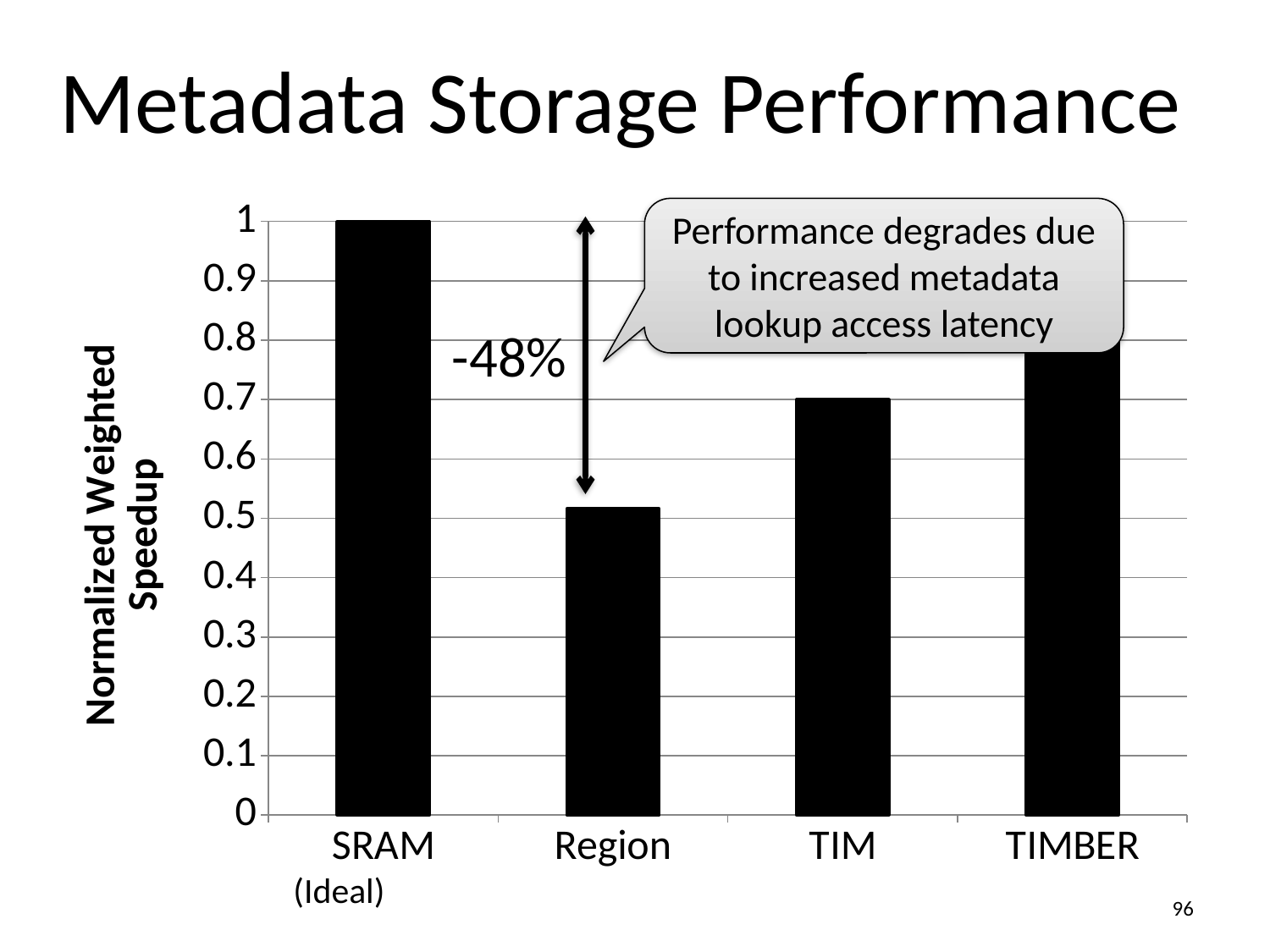
Which category has the highest normalized weighted speedup? SRAM (Ideal) Is the value for TIM greater or less than 0.8? less What percentage change is annotated between the SRAM and Region bars? -48% How many categories are plotted on the x axis? 4 Which category has the lowest normalized weighted speedup? Region What kind of chart is shown on the slide? bar chart What is the normalized weighted speedup for SRAM (Ideal)? 1 Is the value for Region greater or less than 0.5? greater What is the label of the y axis? Normalized Weighted Speedup Is the value for TIMBER greater or less than 0.7? greater Which has a larger normalized weighted speedup, TIM or Region? TIM